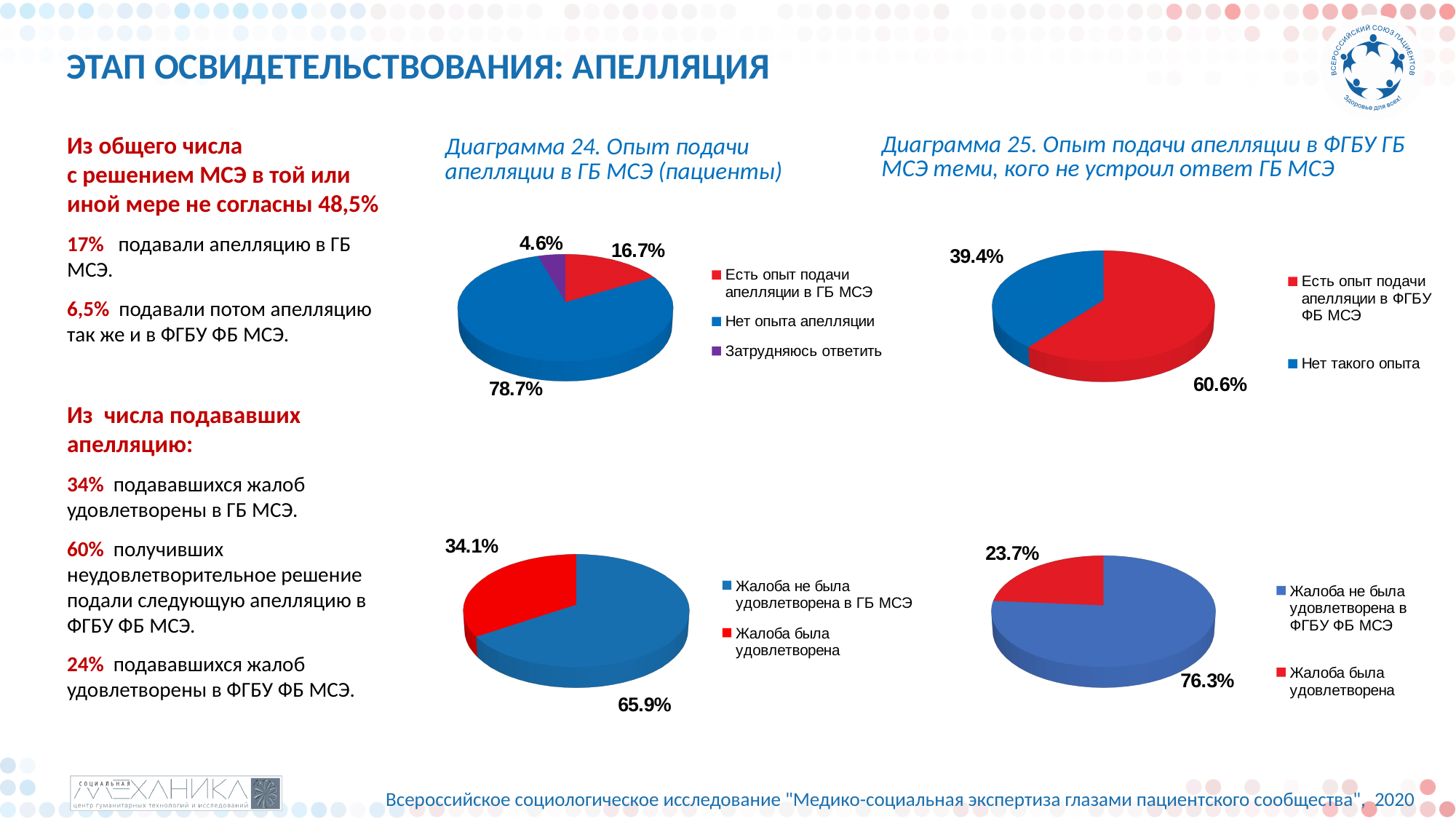
In Диаграмма 24, which category has the smallest slice? Затрудняюсь ответить In Диаграмма 24, what share of respondents have no experience of appeal (Нет опыта апелляции)? 78.7% In the bottom-right pie chart, what is the difference between the two slices? 52.6% In Диаграмма 25, what share of respondents have experience of appealing to ФГБУ ФБ МСЭ? 60.6% In the bottom-right pie chart, what share of complaints were not satisfied in ФГБУ ФБ МСЭ? 76.3% In Диаграмма 25, which category is larger: Есть опыт подачи апелляции в ФГБУ ФБ МСЭ or Нет такого опыта? Есть опыт подачи апелляции в ФГБУ ФБ МСЭ In Диаграмма 24, what share of respondents answered Затрудняюсь ответить? 4.6% What type of chart is used for Диаграмма 25? Pie chart In the bottom-left pie chart, what share of complaints were not satisfied in ГБ МСЭ? 65.9% In Диаграмма 25, what is the difference between the two slices? 21.2% In the bottom-left pie chart, what share of complaints were satisfied (Жалоба была удовлетворена)? 34.1% How many slices does the pie in Диаграмма 24 have? 3